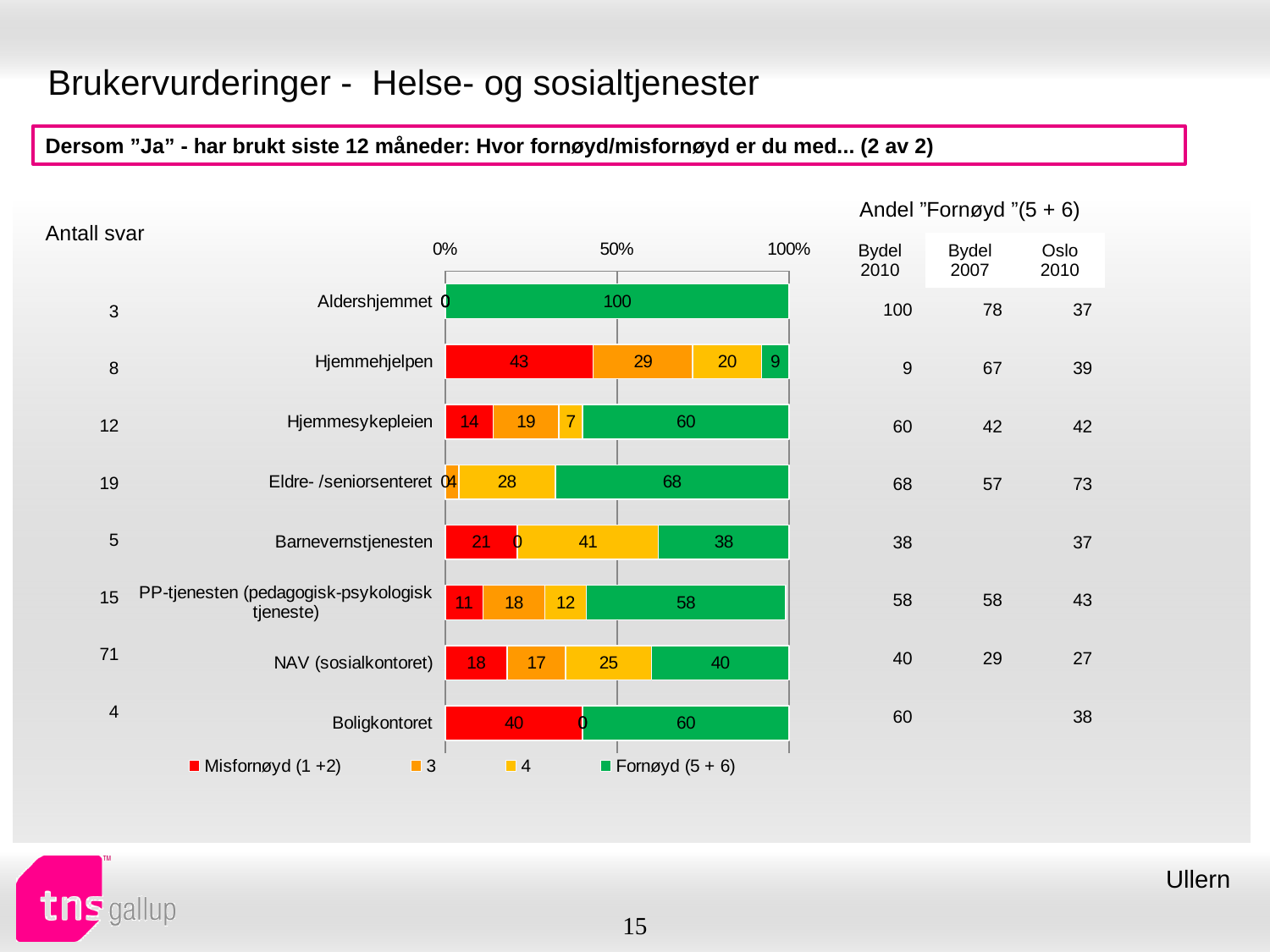
How many categories are shown in the chart? 8 What is the difference between the Fornøyd (5 + 6) values for Boligkontoret and NAV (sosialkontoret)? 20 Which category has the highest Fornøyd (5 + 6) value? Aldershjemmet Is the Fornøyd (5 + 6) value for Eldre- /seniorsenteret greater or less than 50%? greater What kind of chart is shown on the slide? Stacked bar chart How many series does the legend list? 4 What is the value of the '4' segment for NAV (sosialkontoret)? 25 Which has the larger Misfornøyd (1 +2) value, Boligkontoret or NAV (sosialkontoret)? Boligkontoret Which category has the lowest Fornøyd (5 + 6) value? Hjemmehjelpen What colour represents the Fornøyd (5 + 6) series in the chart? Green What is the value of the Fornøyd (5 + 6) segment for Hjemmesykepleien? 60 What is the value of the Misfornøyd (1 +2) segment for Hjemmehjelpen? 43